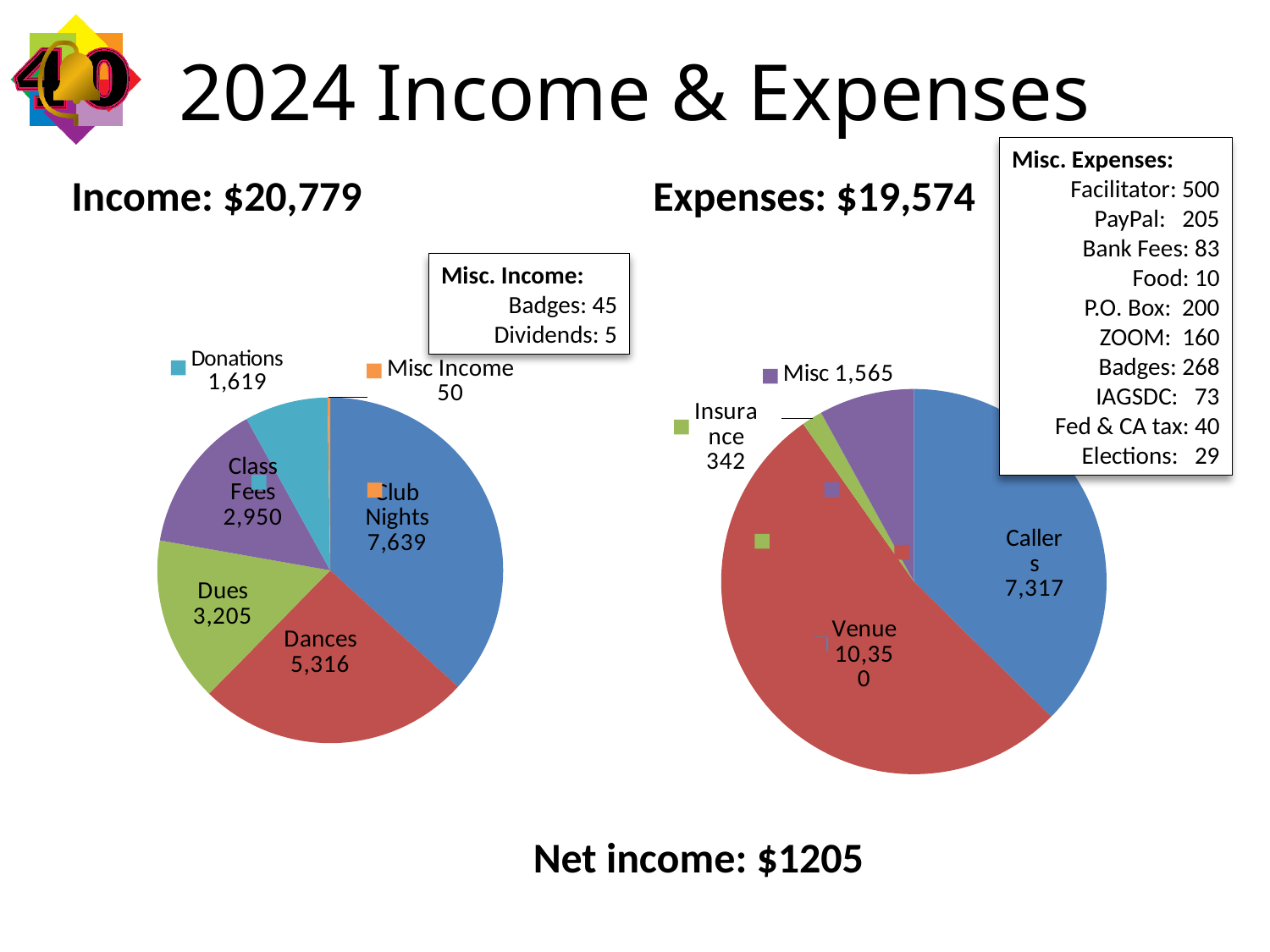
In the Expenses pie chart, what is the value for Insurance? 342 In the Income pie chart, what is the value for Dues? 3,205 In the Income pie chart, what is the value for Club Nights? 7,639 In the Income pie chart, which category is the smallest? Misc Income How many categories does the Income pie chart show? 6 In the Expenses pie chart, what is the difference between Venue and Callers? 3,033 What kind of chart is used for Expenses? Pie chart In the Income pie chart, which category is the largest? Club Nights In the Income pie chart, which is larger, Dances or Class Fees? Dances In the Expenses pie chart, which category is the largest? Venue In the Expenses pie chart, what is the value for Venue? 10,350 How many categories does the Expenses pie chart show? 4